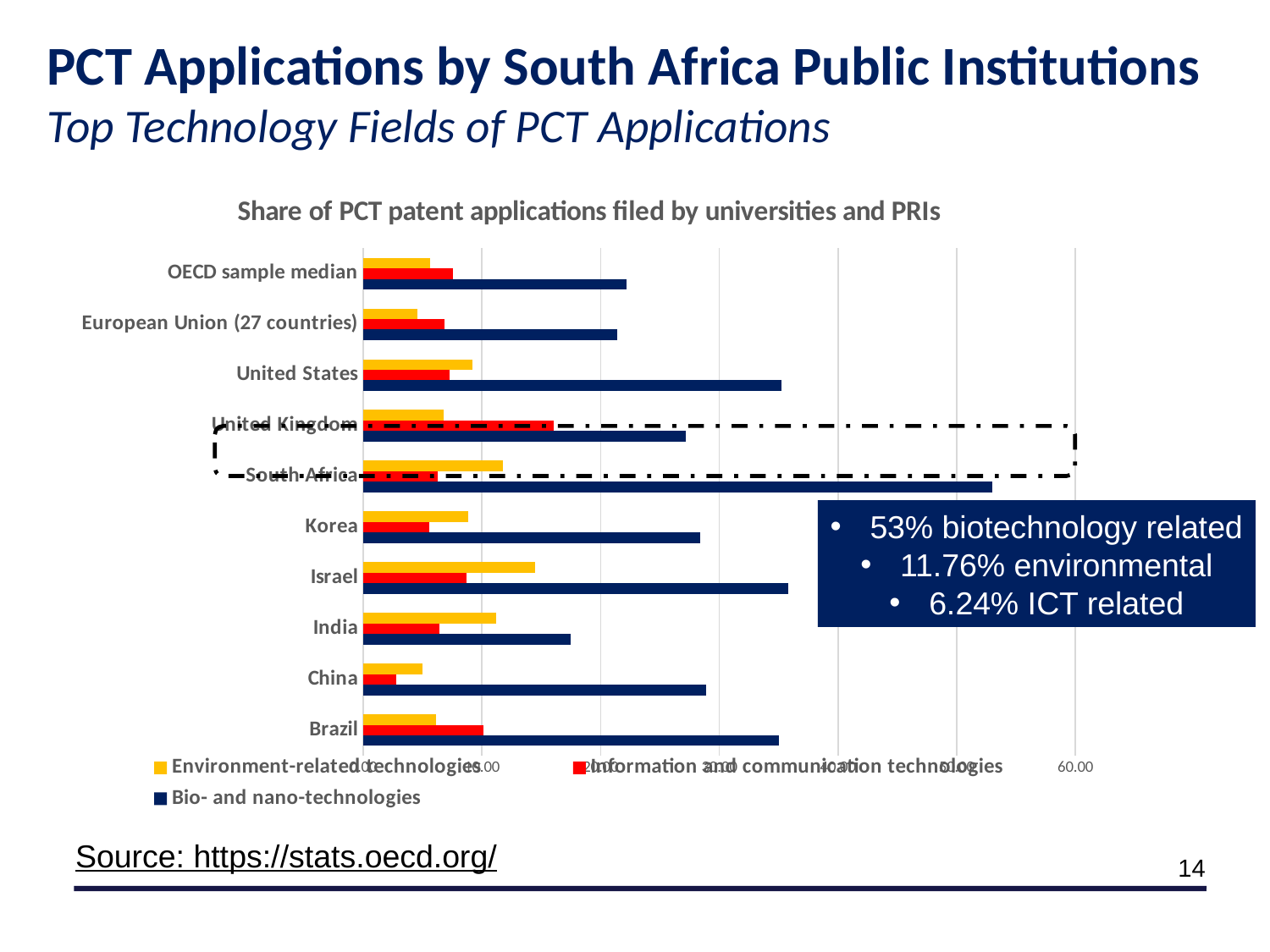
Which is larger: the Bio- and nano-technologies value for South Africa or for the United States? South Africa Which country has the lowest value for Information and communication technologies? China Is the value for India in Bio- and nano-technologies greater or less than 20.00? less Which country has the highest value for Bio- and nano-technologies? South Africa How many series does the chart legend list? 3 Which country has the lowest value for Bio- and nano-technologies? India What is the title of the chart? Share of PCT patent applications filed by universities and PRIs Which country has the highest value for Environment-related technologies? Israel How many countries or regions are shown on the chart's vertical axis? 10 What kind of chart is shown on the slide? Bar chart Is the value for South Africa in Bio- and nano-technologies greater or less than 50.00? greater Which country has the highest value for Information and communication technologies? United Kingdom